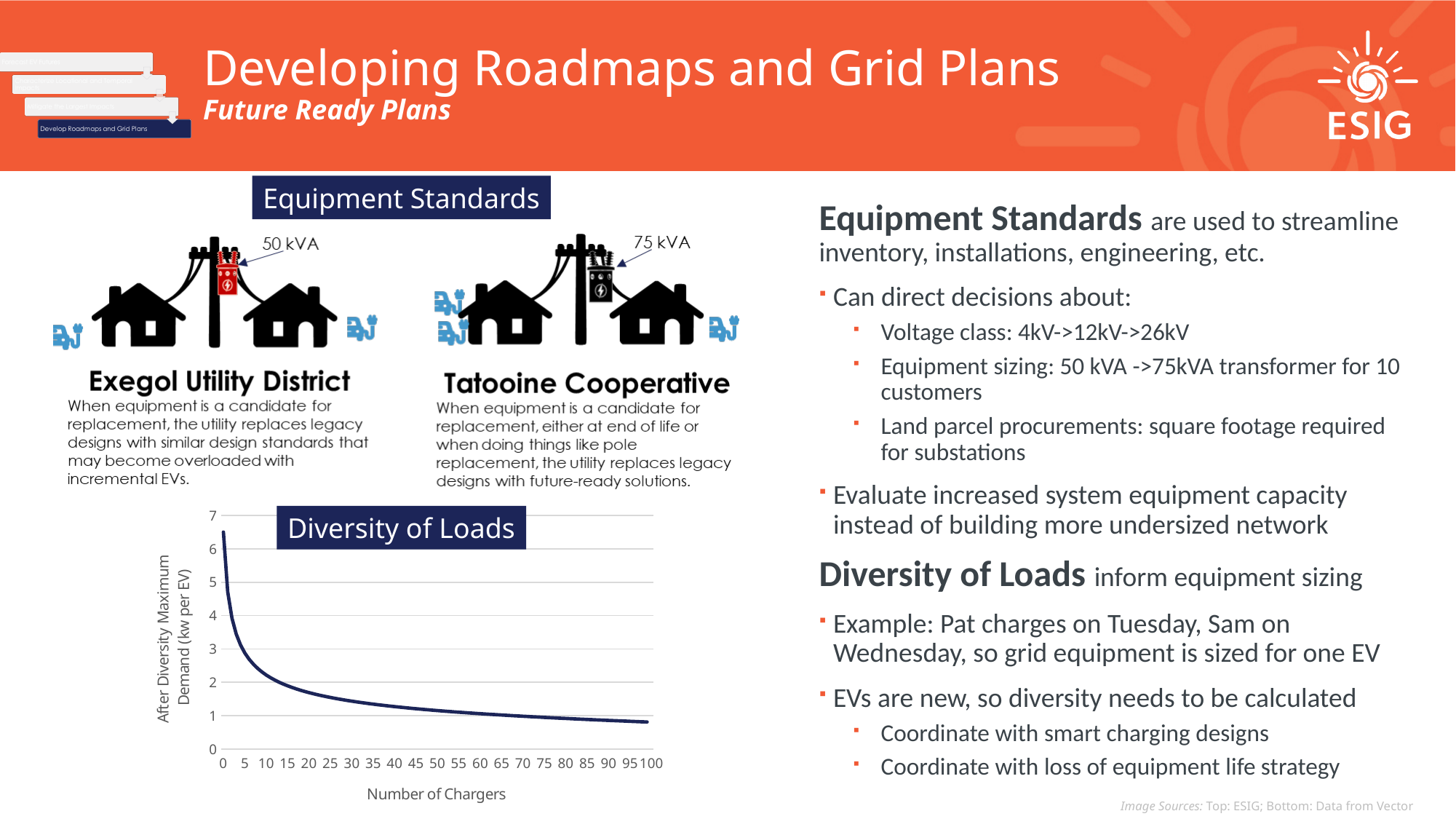
What is the label of the y axis of the Diversity of Loads chart? After Diversity Maximum Demand (kw per EV) In the Diversity of Loads chart, is the value at 10 chargers greater or less than 2? greater In the Diversity of Loads chart, is the value at 100 chargers greater or less than 1? less In the Diversity of Loads chart, does the after-diversity maximum demand rise or fall as the number of chargers increases? fall In the Diversity of Loads chart, is the value at 0 chargers greater or less than 6? greater What kind of chart is the Diversity of Loads chart? line chart In the Diversity of Loads chart, which has the higher demand per EV: 5 chargers or 50 chargers? 5 chargers What is the largest number of chargers shown on the x axis of the Diversity of Loads chart? 100 What is the label of the x axis of the Diversity of Loads chart? Number of Chargers What is the highest value shown on the y axis of the Diversity of Loads chart? 7